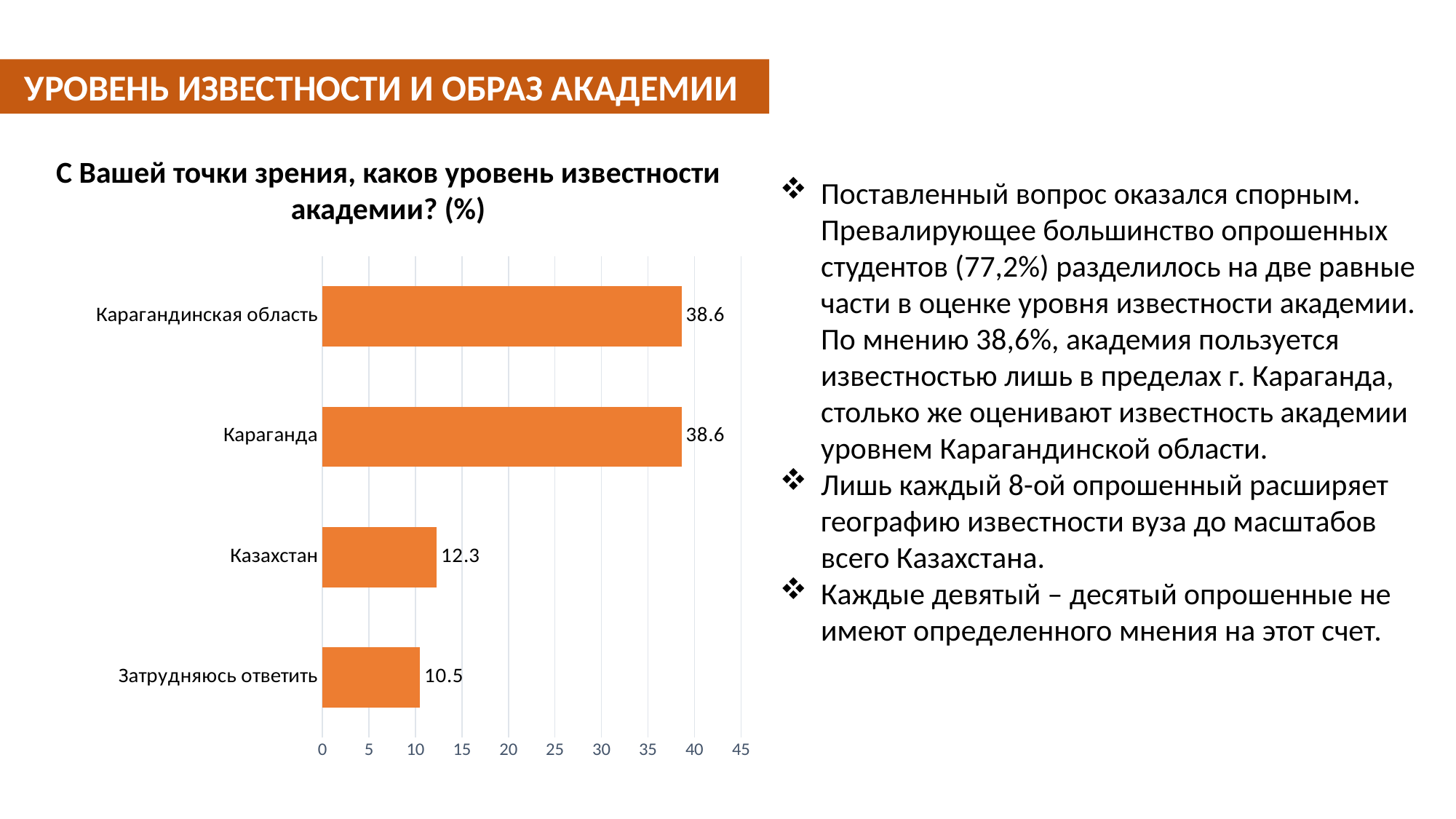
Which category has the lowest value? Затрудняюсь ответить What is the title of the chart? С Вашей точки зрения, каков уровень известности академии? (%) Is the value for Караганда greater or less than 35? greater What is the value for Казахстан? 12.3 Which is larger, the value for Казахстан or the value for Затрудняюсь ответить? Казахстан What is the difference between the values for Казахстан and Затрудняюсь ответить? 1.8 What is the difference between the values for Караганда and Казахстан? 26.3 What is the value for Затрудняюсь ответить? 10.5 How many categories are shown in the chart? 4 What kind of chart is shown on the slide? bar chart What is the value for Карагандинская область? 38.6 What is the value for Караганда? 38.6